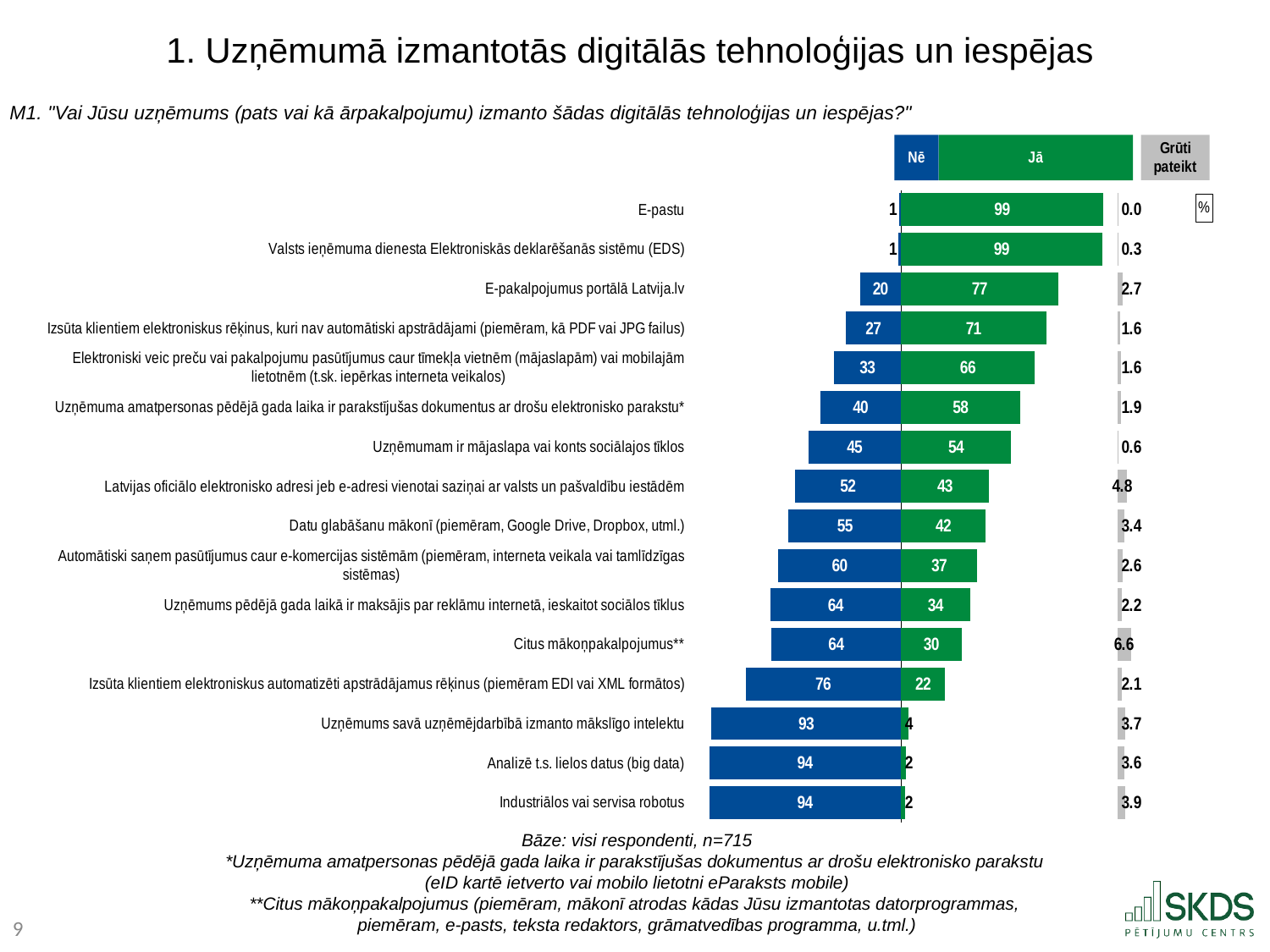
What colour represents the "Jā" series in the chart? Green What is the "Jā" value for "E-pakalpojumus portālā Latvija.lv"? 77 Which has the larger "Nē" value: "Citus mākoņpakalpojumus**" or "Izsūta klientiem elektroniskus automatizēti apstrādājamus rēķinus (piemēram EDI vai XML formātos)"? Izsūta klientiem elektroniskus automatizēti apstrādājamus rēķinus (piemēram EDI vai XML formātos) How many series does the legend list? 3 What kind of chart is shown on the slide? Bar chart For "Uzņēmumam ir mājaslapa vai konts sociālajos tīklos", how much larger is the "Jā" value than the "Nē" value? 9 Which category has the highest "Grūti pateikt" value? Citus mākoņpakalpojumus** Which category has the lowest "Grūti pateikt" value? E-pastu How many categories (technologies) are shown in the chart? 16 What is the "Grūti pateikt" value for "Citus mākoņpakalpojumus**"? 6.6 What is the "Nē" value for "Uzņēmums savā uzņēmējdarbībā izmanto mākslīgo intelektu"? 93 What is the "Nē" value for "Datu glabāšanu mākonī (piemēram, Google Drive, Dropbox, utml.)"? 55